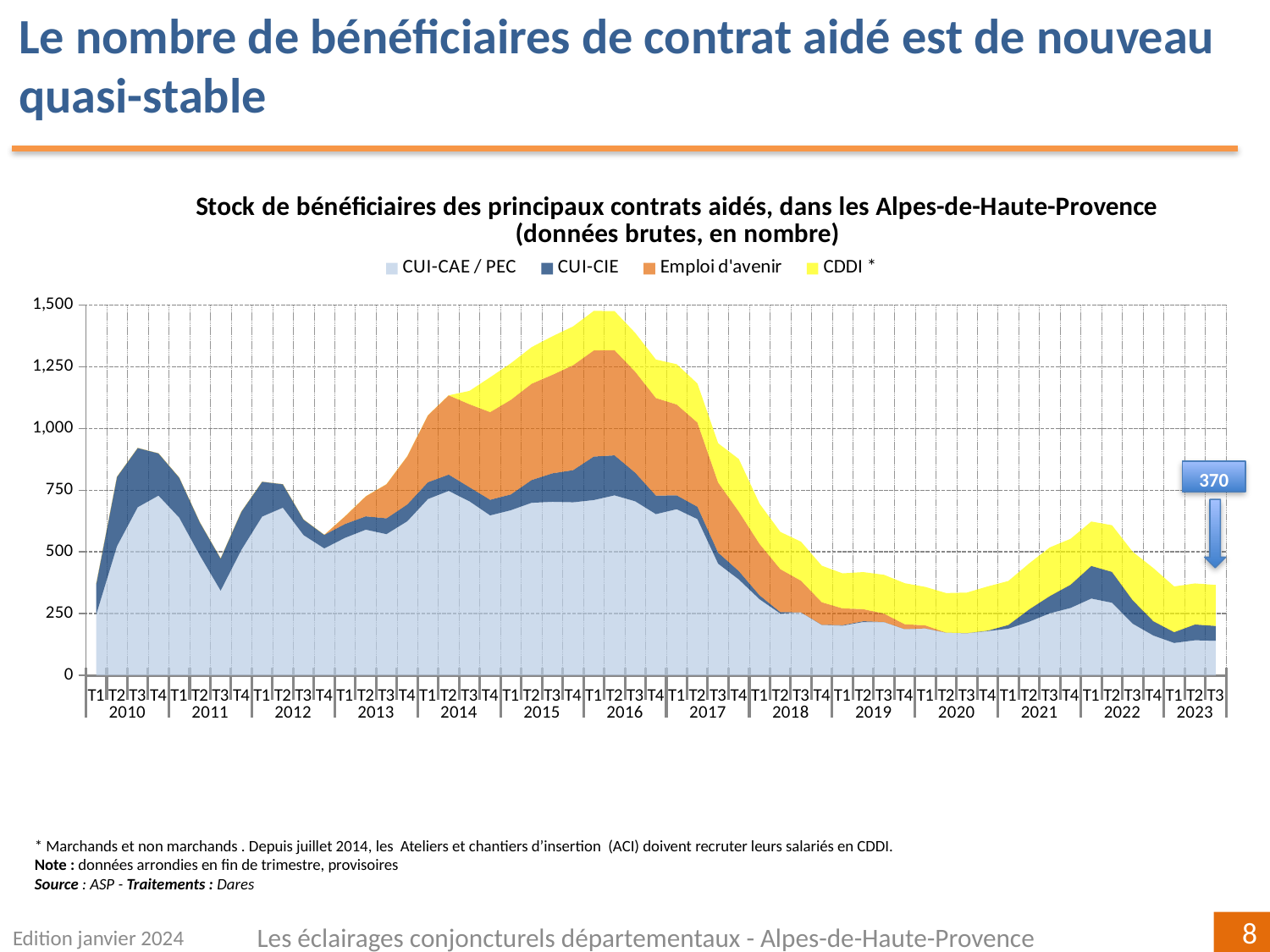
How many series does the legend list? 4 Which series is shown in yellow? CDDI * Is the total stock of beneficiaries at T1 2022 greater or less than 500? greater How many years are labelled on the x axis? 14 Between 2016 and 2020, does the total stock of beneficiaries rise or fall? Fall In which year does the total stock of beneficiaries reach its highest level? 2016 Is the total stock of beneficiaries at T4 2019 greater or less than 500? less What is the title of the chart? Stock de bénéficiaires des principaux contrats aidés, dans les Alpes-de-Haute-Provence (données brutes, en nombre) Is the total stock of beneficiaries at T2 2016 greater or less than 1,250? greater Which is larger, the total stock of beneficiaries at T1 2016 or at T1 2022? T1 2016 What value does the callout label give for the total stock of beneficiaries at T3 2023? 370 What kind of chart is shown on the slide? Stacked area chart